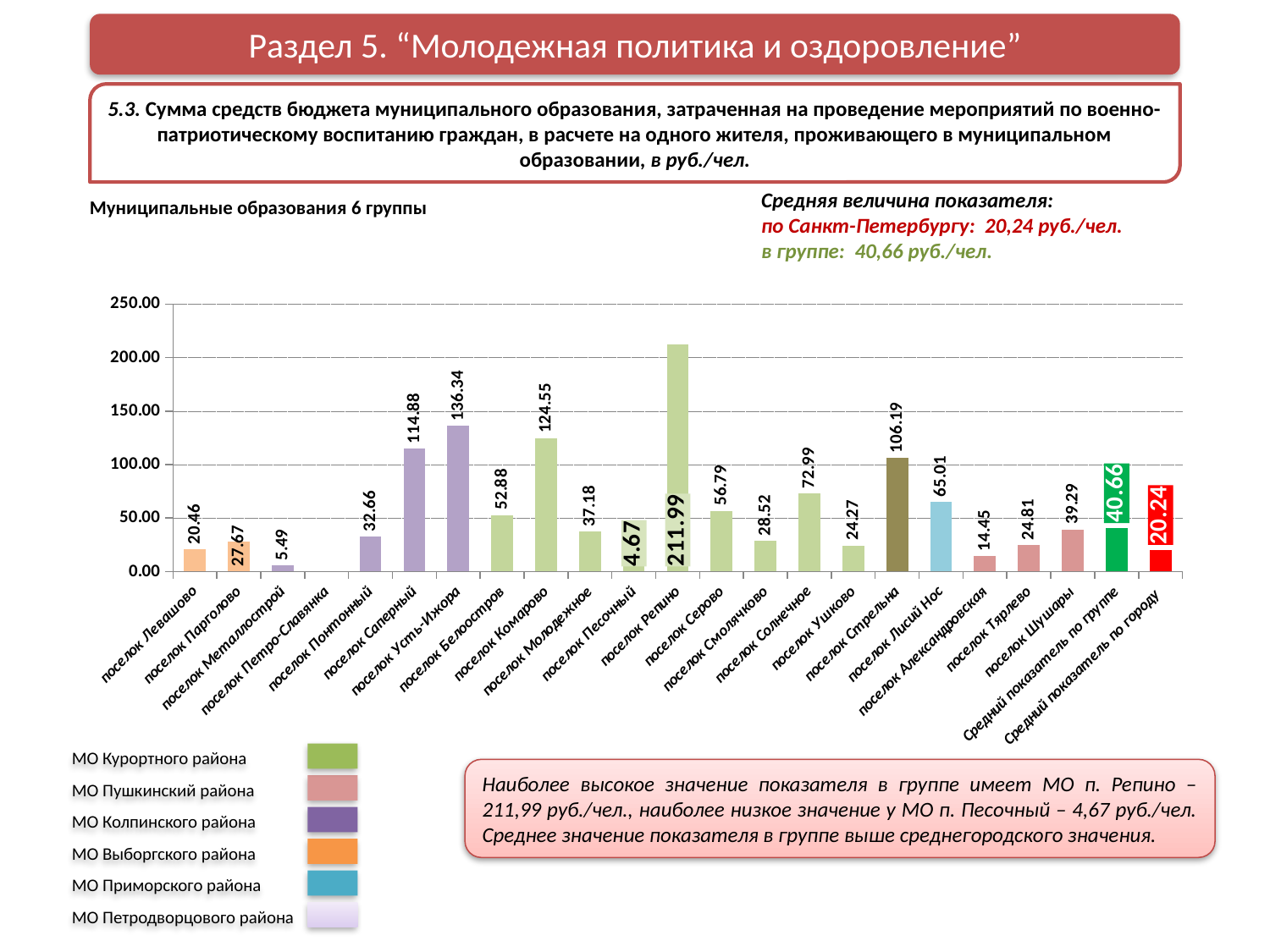
What is the value shown for Средний показатель по городу? 20.24 What kind of chart is shown on the slide? bar chart Which category has the highest value in the chart? поселок Репино What is the difference between Средний показатель по группе and Средний показатель по городу? 20.42 Which is larger, the value for поселок Комарово or the value for поселок Стрельна? поселок Комарово Is the value for поселок Репино greater or less than 200? greater How many entries does the legend below the chart list? 6 What is the value for поселок Репино? 211.99 What is the value for поселок Усть-Ижора? 136.34 What is the difference between the values for поселок Усть-Ижора and поселок Саперный? 21.46 How many categories are shown on the x axis of the chart? 23 Which category has the lowest plotted value in the chart? поселок Песочный